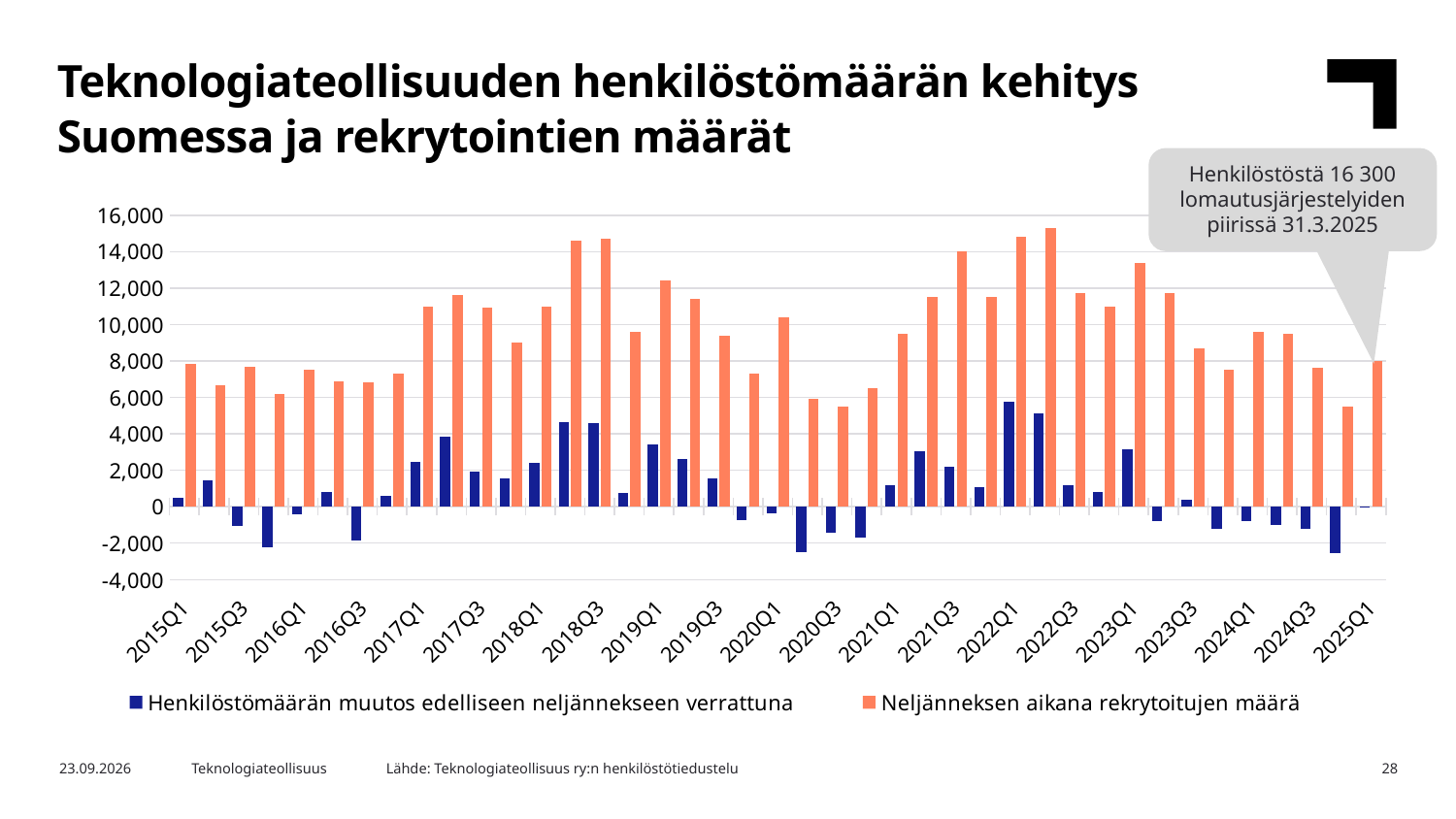
In which quarter is the number of recruits (Neljänneksen aikana rekrytoitujen määrä) highest? 2022Q2 Does the number of recruits generally rise or fall from 2020Q2 to 2022Q2? rise What does the callout on the chart say? Henkilöstöstä 16 300 lomautusjärjestelyiden piirissä 31.3.2025 Is the change in personnel in 2020Q2 greater or less than 0? less What kind of chart is shown on the slide? Bar chart Which quarter has more recruits, 2018Q3 or 2019Q3? 2018Q3 Which series is shown in orange according to the legend? Neljänneksen aikana rekrytoitujen määrä How many series does the legend list? 2 Is the number of recruits in 2020Q3 greater or less than 8,000? less In which quarter is the change in personnel (Henkilöstömäärän muutos edelliseen neljännekseen verrattuna) highest? 2022Q1 Is the number of recruits in 2022Q2 greater or less than 14,000? greater